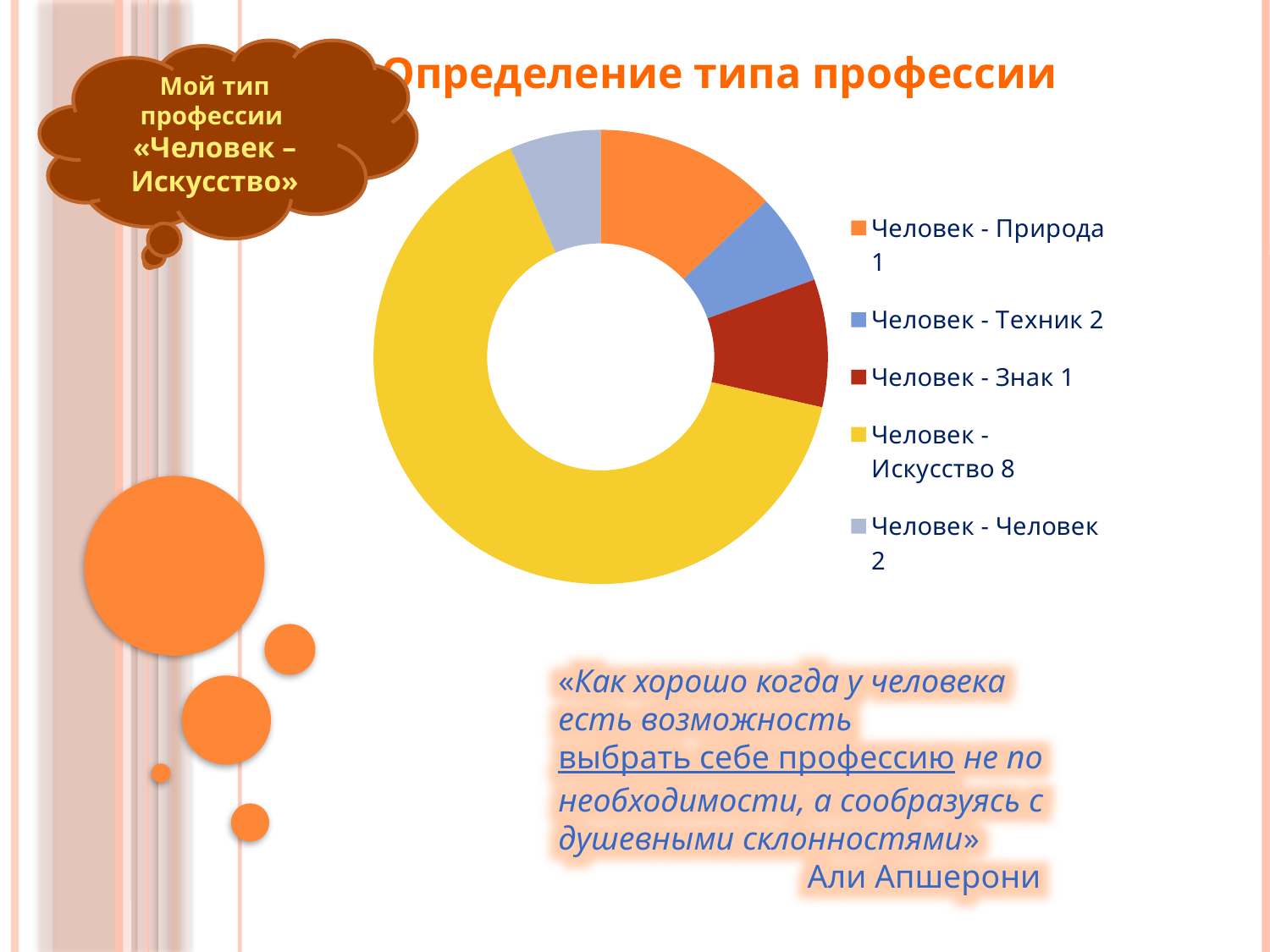
Which legend entry is shown in dark red? Человек - Знак 1 Which slice is larger: Человек - Искусство or Человек - Знак? Человек - Искусство How many categories does the chart's legend list? 5 Which category has the largest slice in the chart? Человек - Искусство 8 What is the title of the chart on the slide? Определение типа профессии Does the Человек - Искусство slice take up more or less than half of the chart? More What kind of chart is shown on the slide? Doughnut (pie) chart Which slice is larger: Человек - Искусство or Человек - Природа? Человек - Искусство What colour is the slice for Человек - Искусство? Yellow